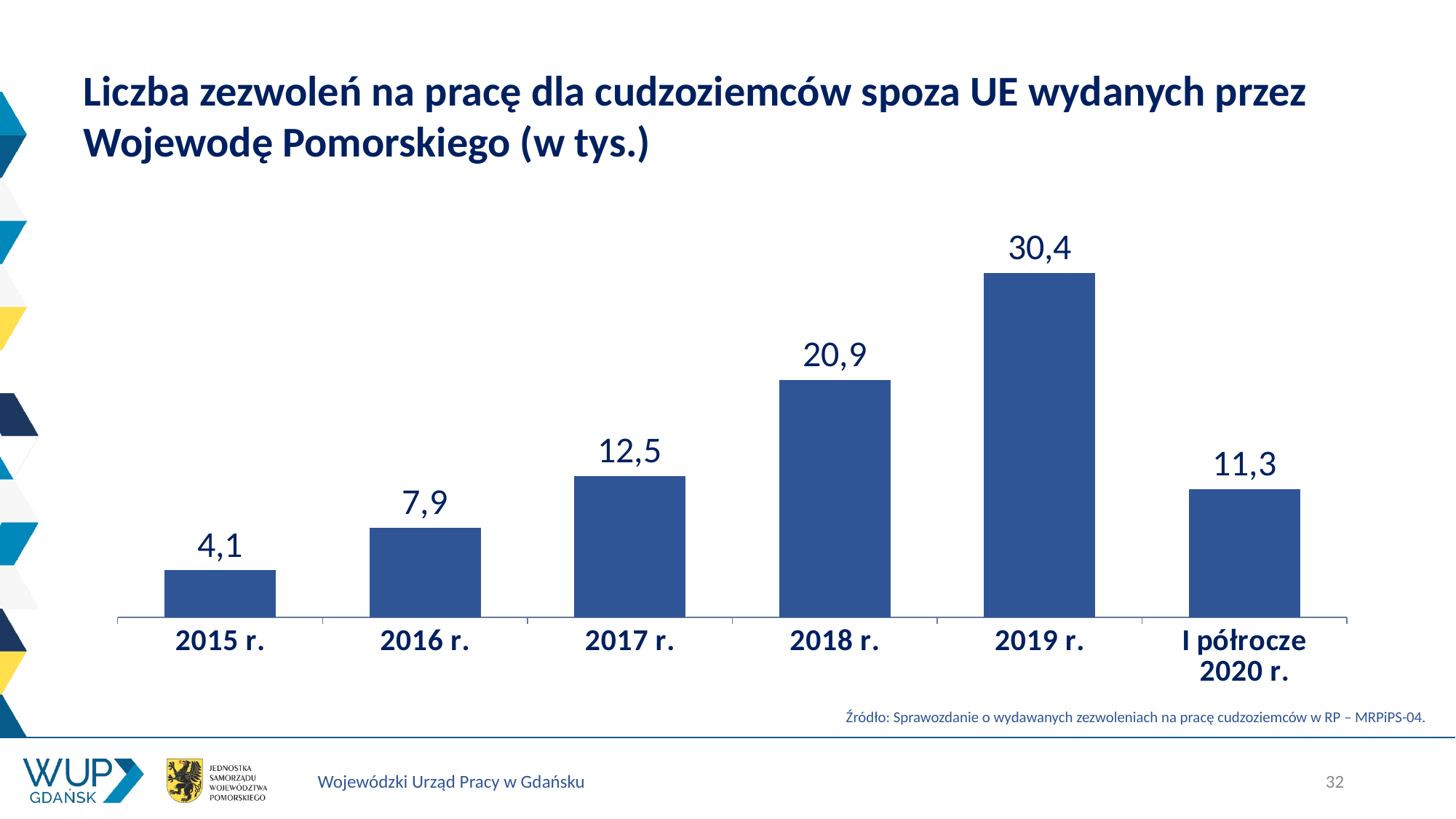
Which category has the highest value? 2019 r. What is the difference between the values for 2019 r. and 2018 r.? 9,5 What is the title of the chart? Liczba zezwoleń na pracę dla cudzoziemców spoza UE wydanych przez Wojewodę Pomorskiego (w tys.) Which category has the lowest value? 2015 r. What kind of chart is shown on the slide? bar chart How many categories are shown on the x axis? 6 What is the difference between the values for 2017 r. and 2016 r.? 4,6 Do the values rise or fall from 2015 r. to 2019 r.? rise Which is larger, the value for 2017 r. or the value for I półrocze 2020 r.? 2017 r. What is the value for 2015 r.? 4,1 What is the value for 2018 r.? 20,9 What is the value for I półrocze 2020 r.? 11,3